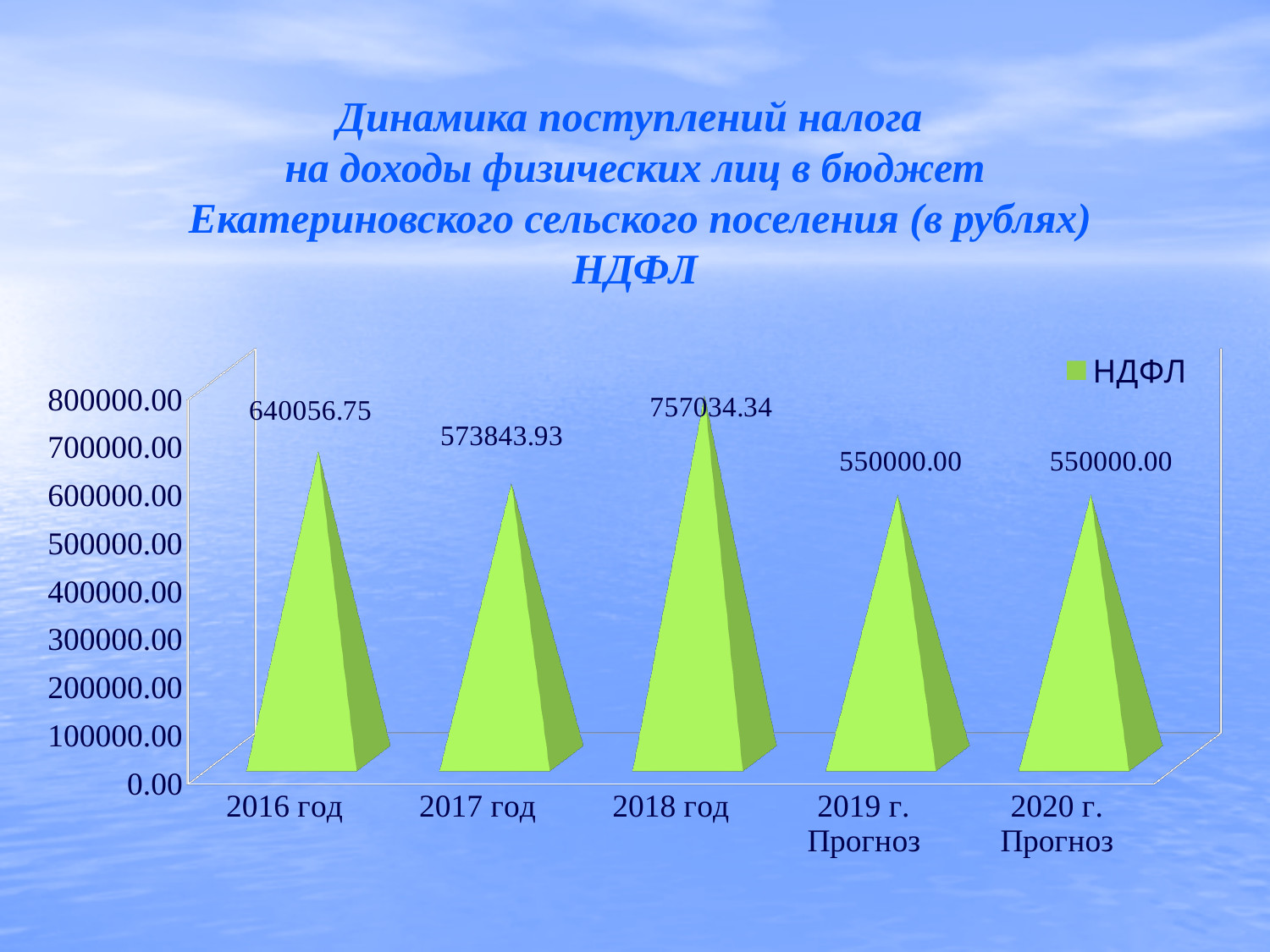
Which year has the highest value? 2018 год What is the value for 2017 год? 573843.93 What is the difference between the values for 2016 год and 2017 год? 66212.82 What is the difference between the values for 2018 год and 2016 год? 116977.59 What is the value for 2018 год? 757034.34 What is the forecast value for 2019 г. Прогноз? 550000.00 What is the value for 2016 год? 640056.75 How many series does the legend list? 1 How many categories are shown on the x axis? 5 Is the value for 2018 год greater or less than 700000.00? greater What kind of chart is shown on the slide? bar chart Which is larger, the value for 2016 год or the value for 2017 год? 2016 год